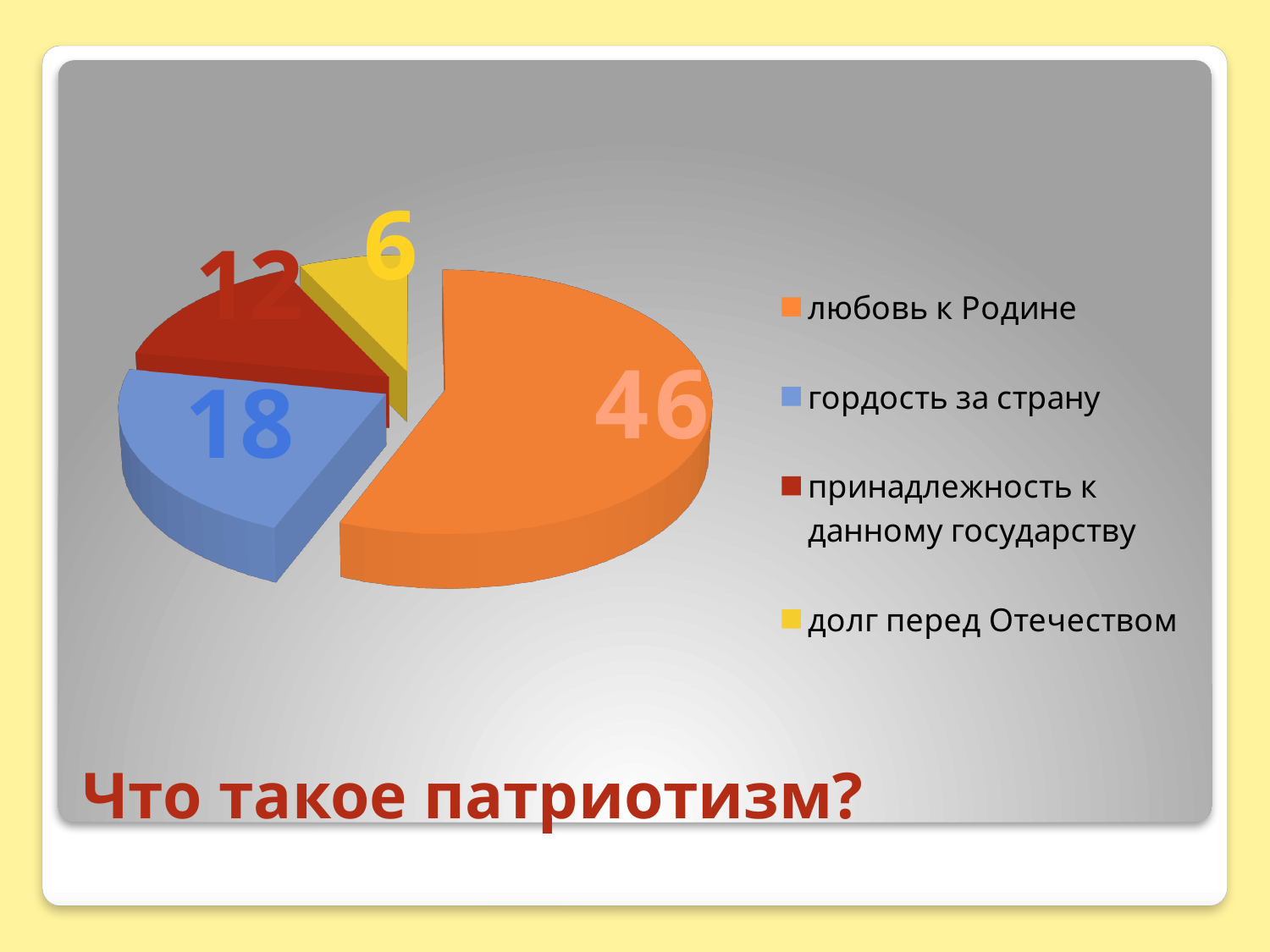
What is the title of the chart? Что такое патриотизм? What type of chart is shown on the slide? pie chart What is the difference between the values for любовь к Родине and гордость за страну? 28 What is the value for гордость за страну? 18 Which category has the smallest slice? долг перед Отечеством What is the value for долг перед Отечеством? 6 Which category has the largest slice? любовь к Родине Which is larger: гордость за страну or принадлежность к данному государству? гордость за страну What is the value for любовь к Родине? 46 What is the difference between the values for принадлежность к данному государству and долг перед Отечеством? 6 What is the value for принадлежность к данному государству? 12 How many categories does the pie chart have? 4